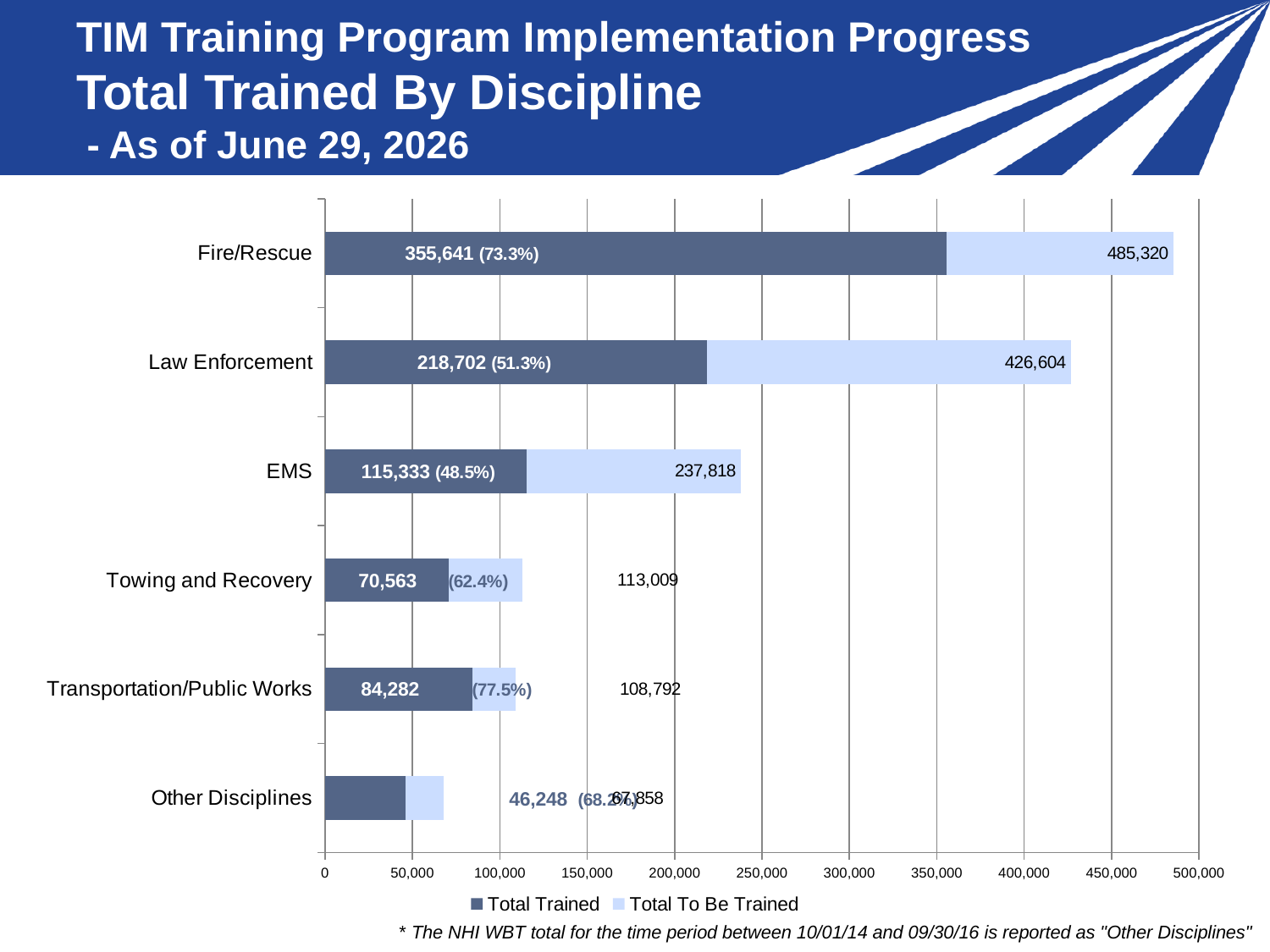
What are the two series named in the legend? Total Trained and Total To Be Trained What is the Total To Be Trained value for Law Enforcement? 426,604 What percentage is shown next to the Total Trained value for EMS? 48.5% Which has the larger Total Trained value, Towing and Recovery or Transportation/Public Works? Transportation/Public Works How many disciplines are shown on the chart? 6 What is the difference between the Total Trained values for Fire/Rescue and Law Enforcement? 136,939 Which discipline has the lowest Total Trained value? Other Disciplines What kind of chart is shown on the slide? bar chart How many series does the legend list? 2 What is the Total Trained value for Fire/Rescue? 355,641 Which discipline has the highest Total Trained value? Fire/Rescue